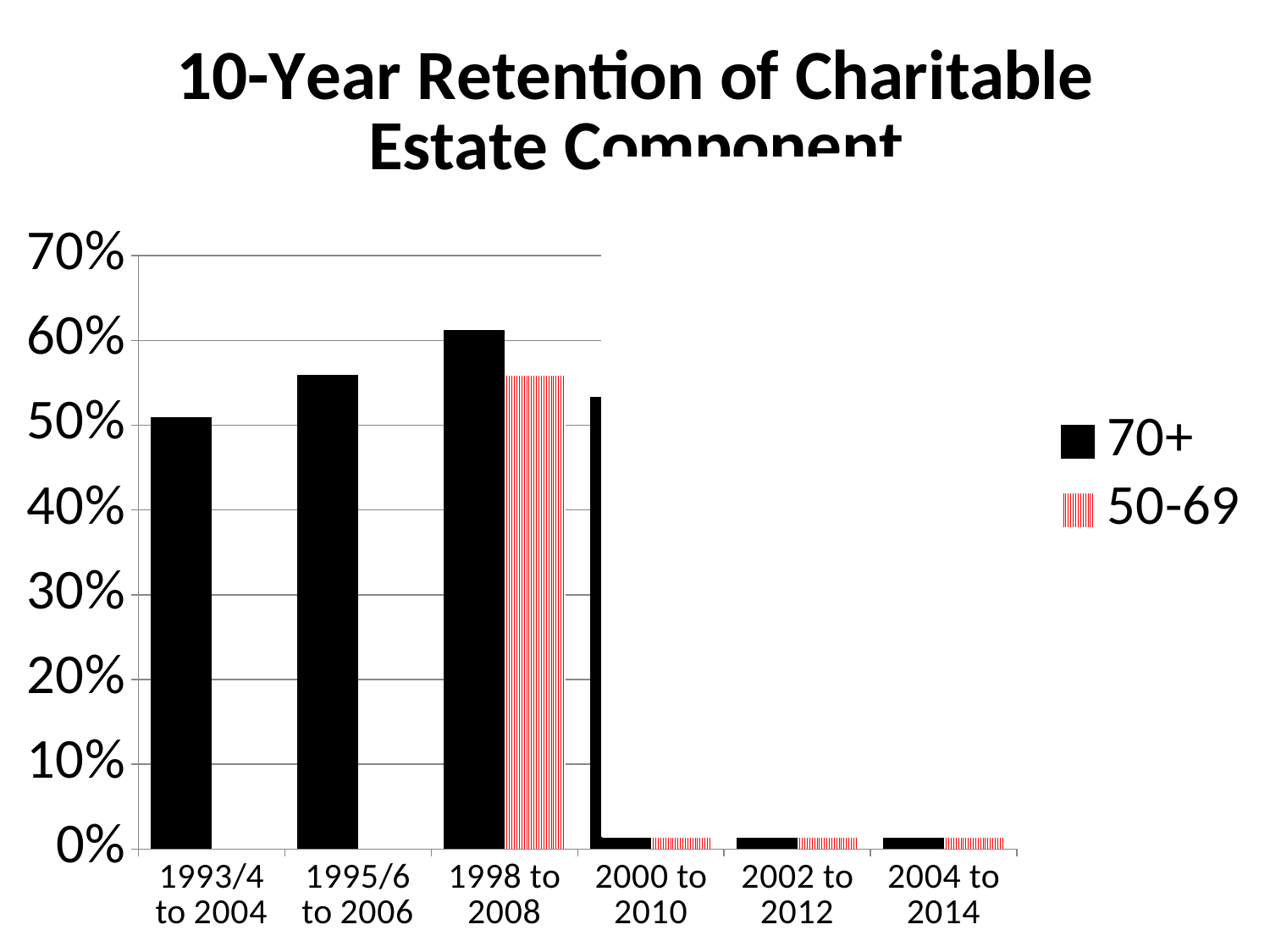
Which category has the highest value for the 50-69 series? 1998 to 2008 Which colour represents the 70+ series in the legend? Black Is the value for 70+ in 2002 to 2012 greater or less than 10%? less Is the value for 70+ in 1993/4 to 2004 greater or less than 40%? greater How many categories are shown on the x axis? 6 Which category has the highest value for the 70+ series? 1998 to 2008 In 1998 to 2008, which series has the larger value, 70+ or 50-69? 70+ Is the value for 50-69 in 1998 to 2008 greater or less than 50%? greater How many series does the legend list? 2 For the 70+ series, which is larger: 1993/4 to 2004 or 1995/6 to 2006? 1995/6 to 2006 What kind of chart is shown on the slide? Bar chart